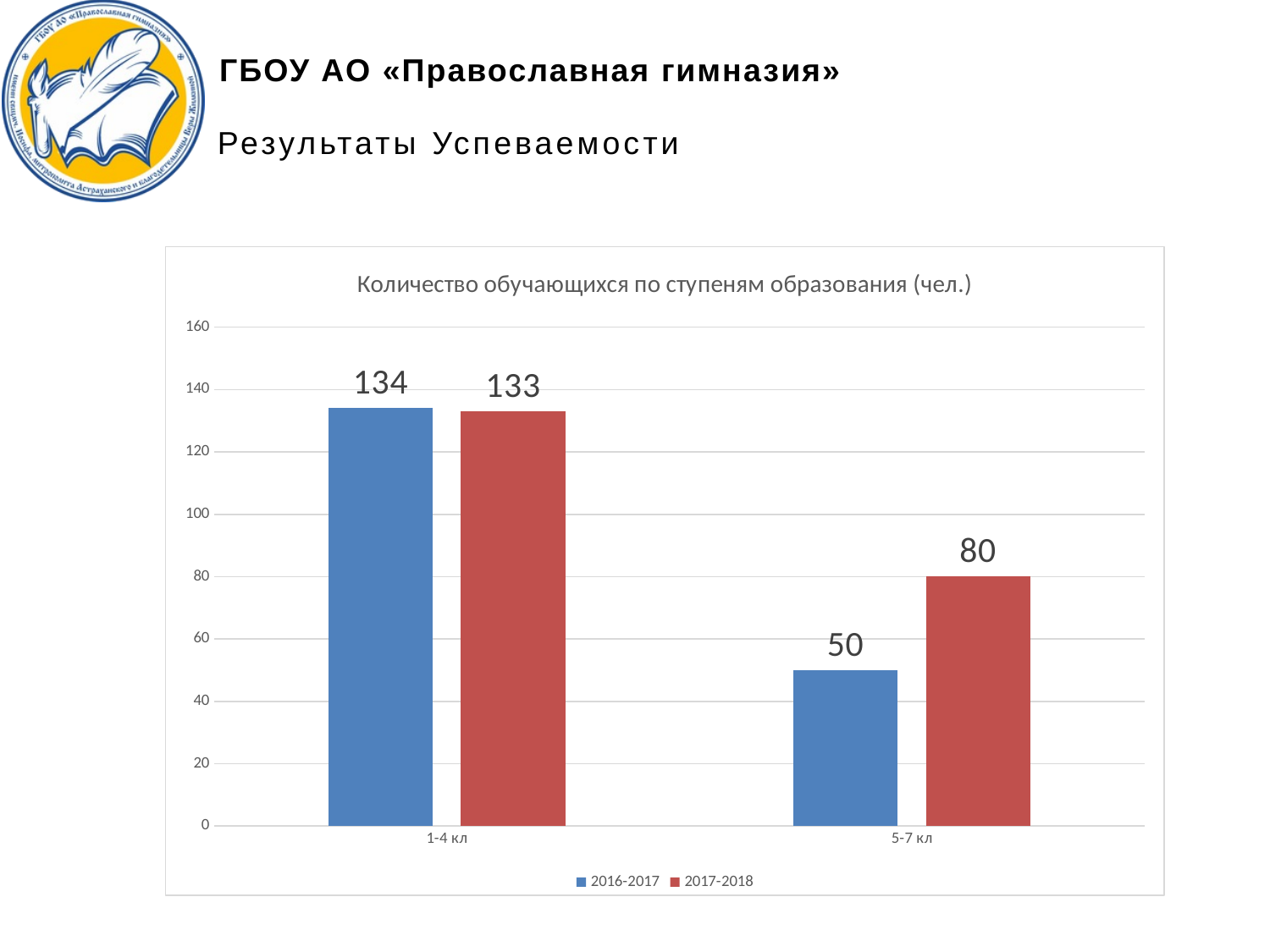
What is the value for 5-7 кл in the 2016-2017 series? 50 What kind of chart is shown on the slide? bar chart Which category has the highest value in the 2017-2018 series? 1-4 кл What is the title of the chart? Количество обучающихся по ступеням образования (чел.) What is the value for 5-7 кл in the 2017-2018 series? 80 How many series does the legend list? 2 Which category has the lowest value in the 2016-2017 series? 5-7 кл What is the difference between the 2017-2018 and 2016-2017 values for 5-7 кл? 30 What is the value for 1-4 кл in the 2017-2018 series? 133 What is the value for 1-4 кл in the 2016-2017 series? 134 For 5-7 кл, which series has the larger value, 2016-2017 or 2017-2018? 2017-2018 How many categories are shown on the x axis? 2